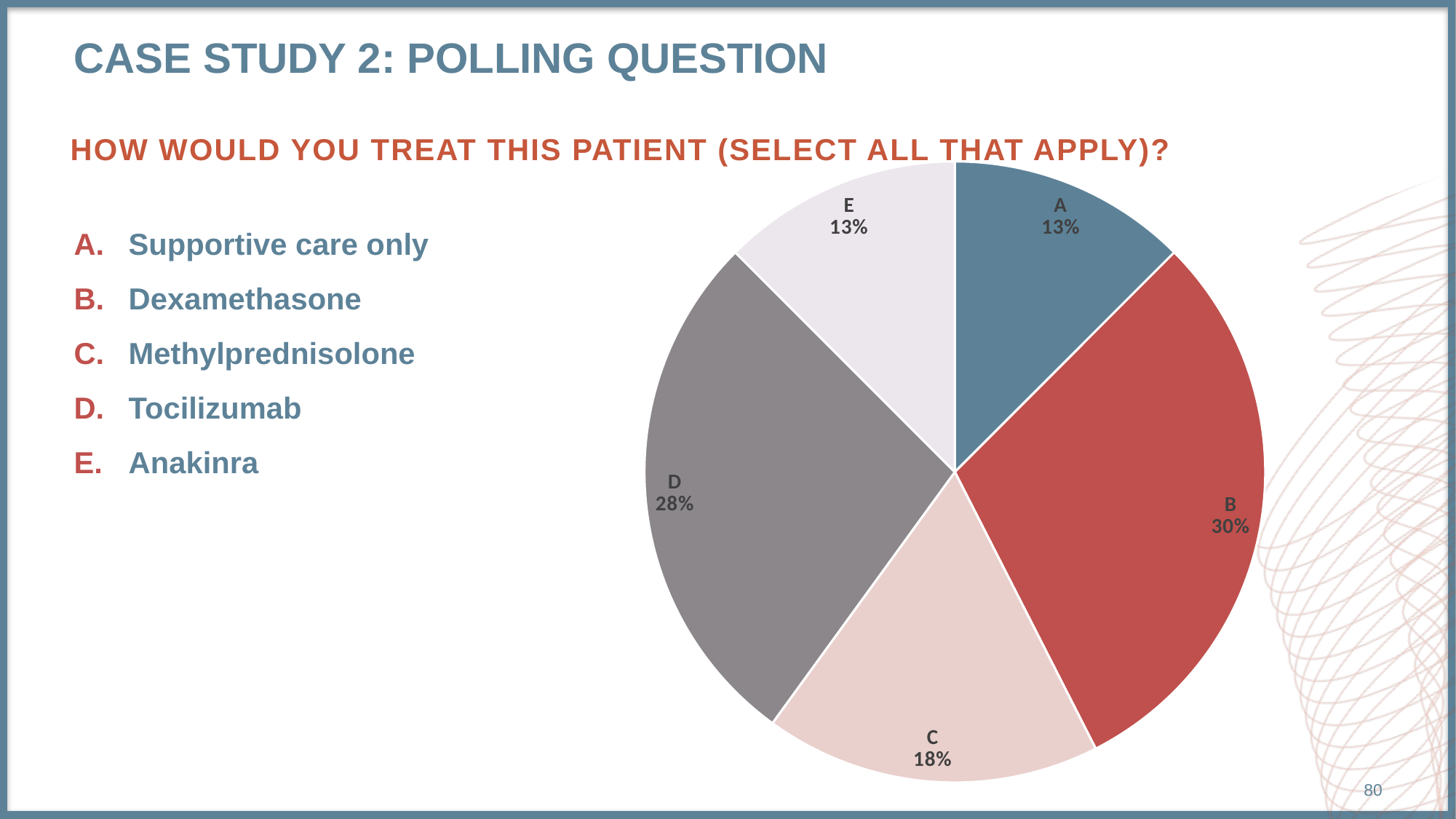
Which option received the largest share of responses? B What type of chart is shown on the slide? Pie chart What is the difference in percentage points between option B and option D? 2% What share of the pie does option C (Methylprednisolone) have? 18% What is the difference between the shares for option D and option C? 10% What colour is the slice for option B? Red Which has a larger share, option C or option E? C What percentage of respondents selected option B (Dexamethasone)? 30% How many slices does the pie chart have? 5 Which options are tied for the smallest share of responses? A and E What percentage is shown for option A (Supportive care only)? 13% What percentage is shown for slice D in the pie chart? 28%